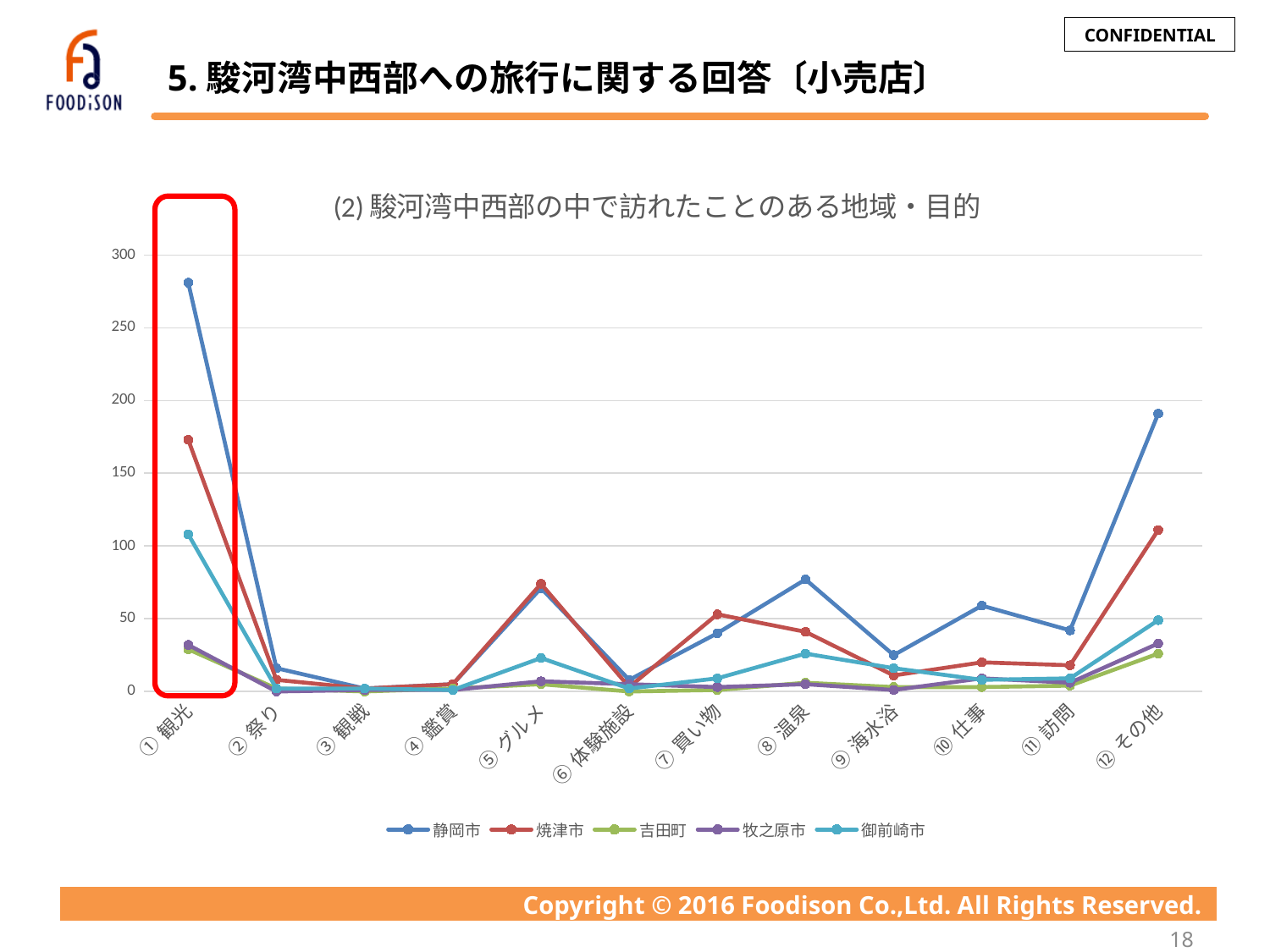
Is the value for 静岡市 at ⑫ その他 greater or less than 150? greater How many series does the legend list? 5 At ⑧ 温泉, which series has the larger value, 静岡市 or 焼津市? 静岡市 Is the value for 静岡市 at ① 観光 greater or less than 250? greater What kind of chart is shown on the slide? line chart Is the value for 焼津市 at ① 観光 greater or less than 200? less How many categories are plotted along the x axis? 12 What is the title of the chart? (2) 駿河湾中西部の中で訪れたことのある地域・目的 For the 焼津市 series, which category has the highest value? ① 観光 At ⑫ その他, which series has the larger value, 焼津市 or 吉田町? 焼津市 For the 静岡市 series, which category has the highest value? ① 観光